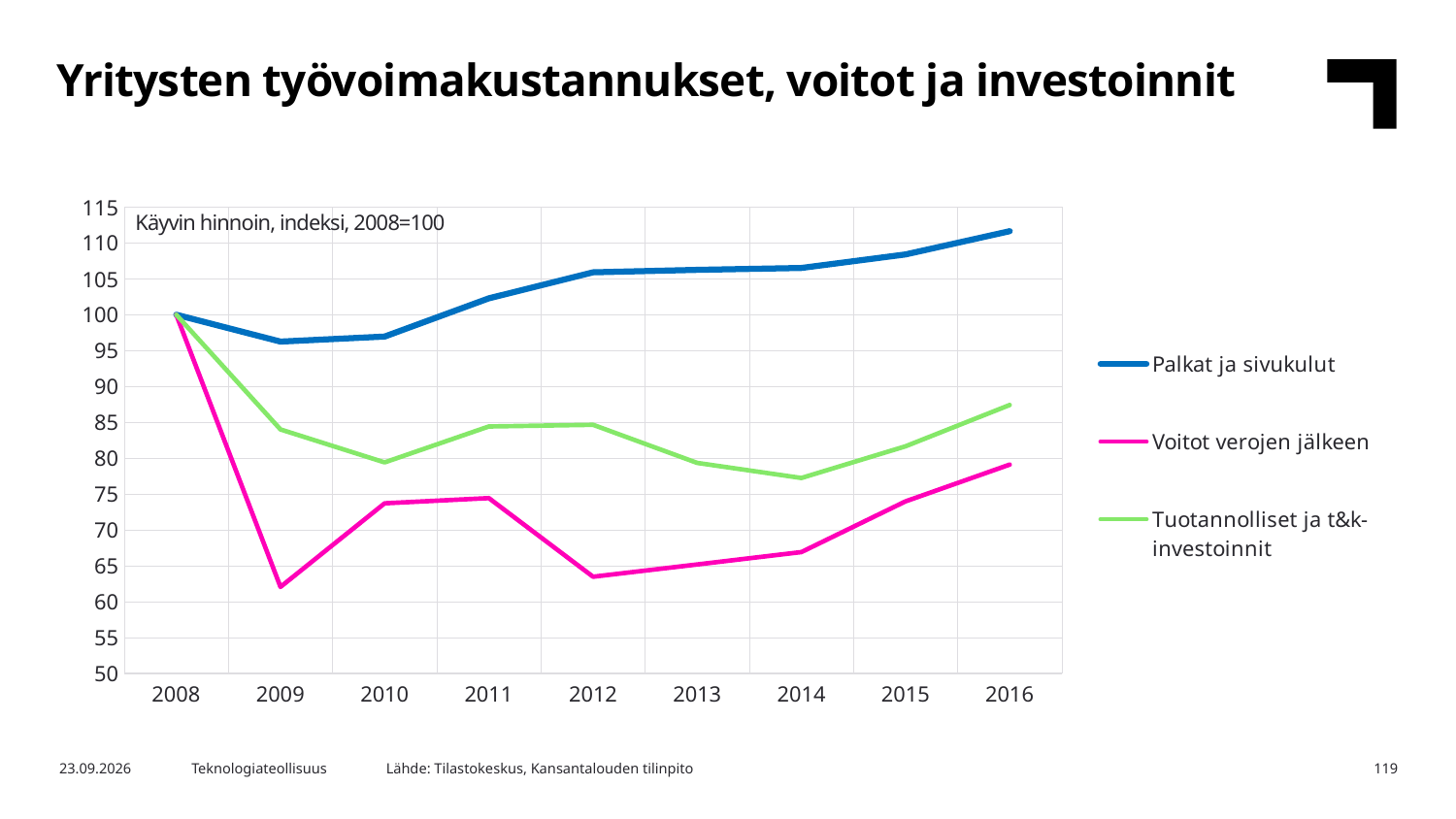
How many years are shown on the x axis? 9 Is the value for Tuotannolliset ja t&k-investoinnit in 2014 greater or less than 80? less Does the Palkat ja sivukulut line rise or fall from 2010 to 2016? Rise What text is shown inside the plot area describing the index? Käyvin hinnoin, indeksi, 2008=100 Which series has the lowest value in 2009? Voitot verojen jälkeen Is the value for Voitot verojen jälkeen in 2009 greater or less than 65? less What kind of chart is shown on the slide? Line chart What is the value of Palkat ja sivukulut in 2008? 100 Is the value for Palkat ja sivukulut in 2016 greater or less than 110? greater How many series does the legend list? 3 Which series has the highest value in 2016? Palkat ja sivukulut In 2016, which is higher: Palkat ja sivukulut or Voitot verojen jälkeen? Palkat ja sivukulut